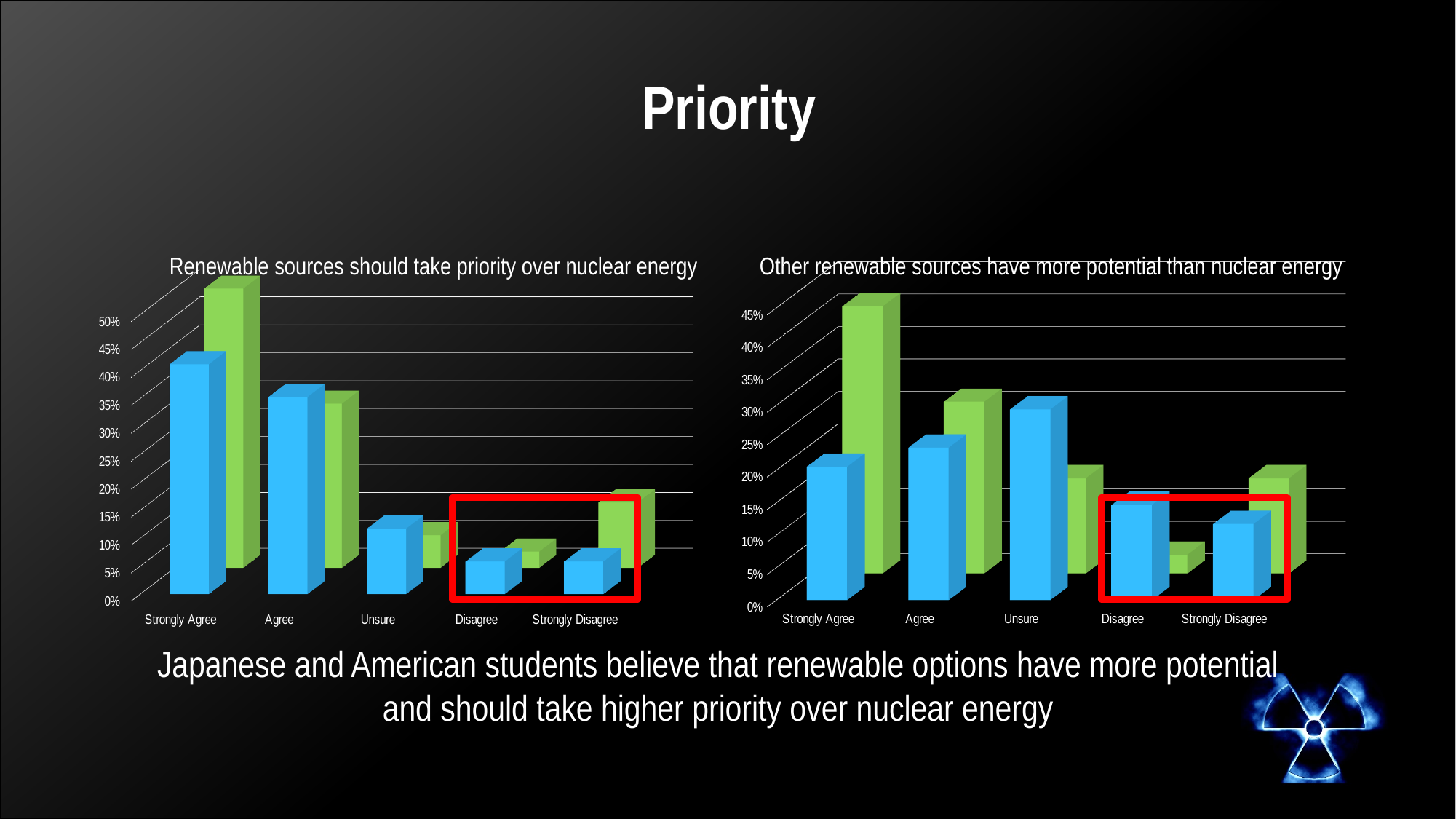
In the right chart ("Other renewable sources have more potential than nuclear energy"), is the blue bar for Unsure greater or less than 20%? greater In the right chart ("Other renewable sources have more potential than nuclear energy"), which category has the tallest green bar? Strongly Agree In the right chart ("Other renewable sources have more potential than nuclear energy"), how many response categories are shown on the x axis? 5 In the left chart ("Renewable sources should take priority over nuclear energy"), is the blue bar for Unsure greater or less than 25%? less What kind of chart is the left chart, titled "Renewable sources should take priority over nuclear energy"? Bar chart In the left chart ("Renewable sources should take priority over nuclear energy"), which blue bar is taller: Strongly Agree or Unsure? Strongly Agree In the right chart ("Other renewable sources have more potential than nuclear energy"), which blue bar is taller: Unsure or Strongly Agree? Unsure In the left chart ("Renewable sources should take priority over nuclear energy"), how many response categories are shown on the x axis? 5 In the left chart ("Renewable sources should take priority over nuclear energy"), which category has the tallest bar? Strongly Agree What is the title of the chart on the right side of the slide? Other renewable sources have more potential than nuclear energy In the left chart ("Renewable sources should take priority over nuclear energy"), is the blue bar for Strongly Agree greater or less than 30%? greater